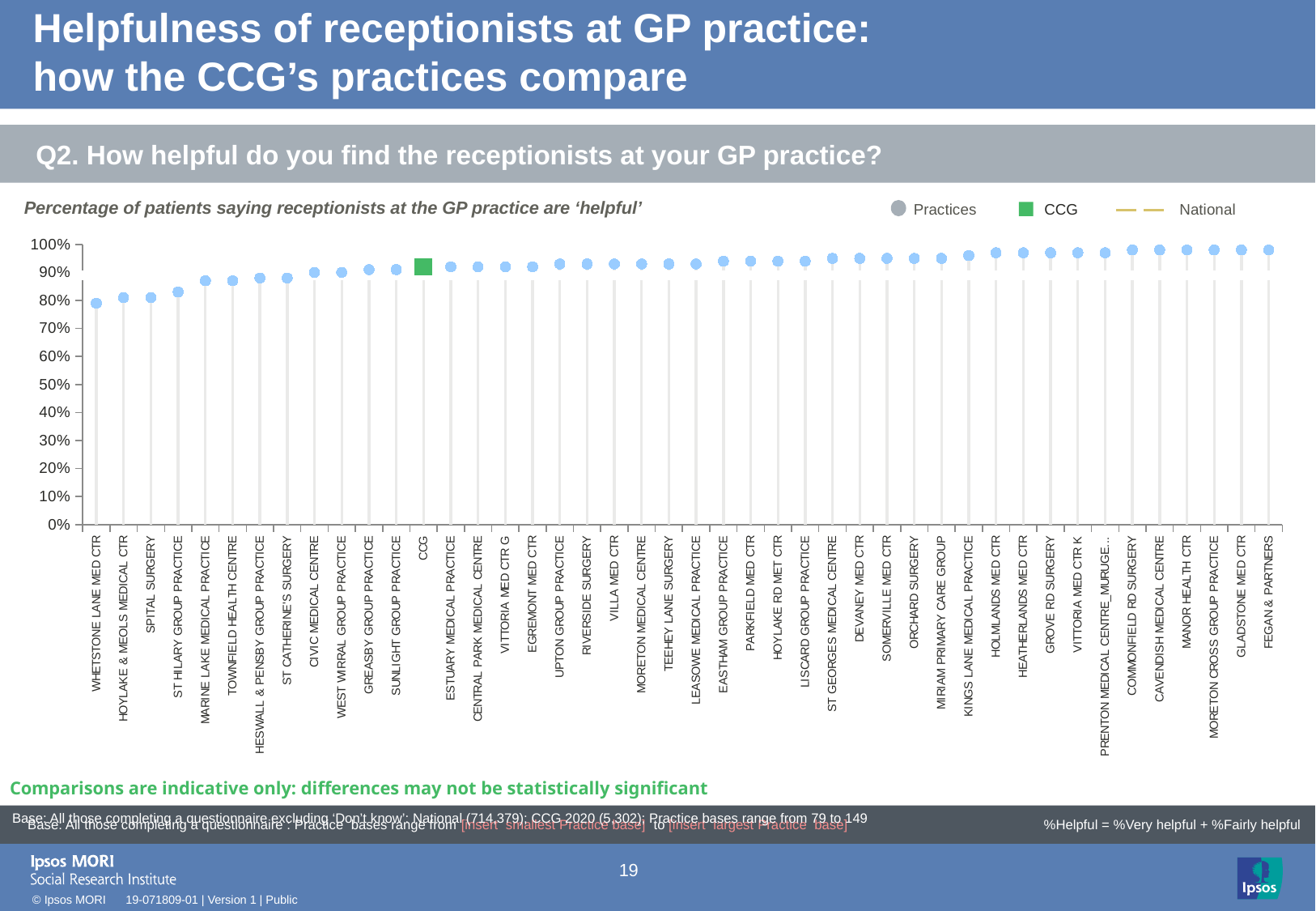
Is the value for FEGAN & PARTNERS greater or less than 90%? greater Is the value for HOLMLANDS MED CTR greater or less than 90%? greater Is the value for SPITAL SURGERY greater or less than 90%? less What is the subtitle describing what the chart plots? Percentage of patients saying receptionists at the GP practice are 'helpful' Which has the larger value, WHETSTONE LANE MED CTR or GLADSTONE MED CTR? GLADSTONE MED CTR What colour is the marker used for the CCG in the chart? green Which has the larger value, SPITAL SURGERY or CIVIC MEDICAL CENTRE? CIVIC MEDICAL CENTRE How many entries does the legend list? 3 Do the values rise or fall moving from left to right along the x axis? rise Which practice has the lowest percentage of patients saying receptionists are helpful? WHETSTONE LANE MED CTR